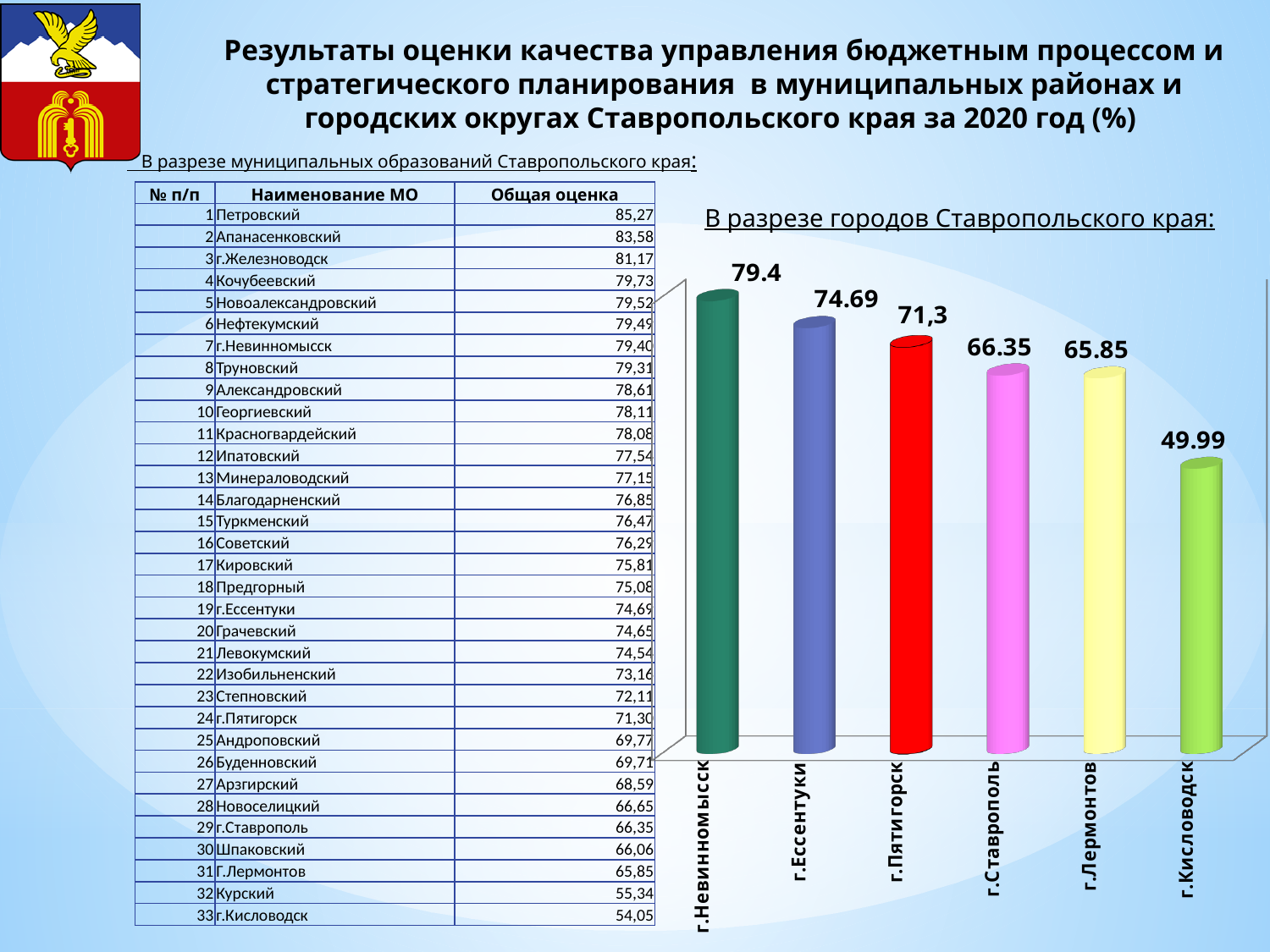
What is the value for г.Невинномысск in the chart? 79.4 Which has a larger value in the chart, г.Ставрополь or г.Лермонтов? г.Ставрополь What is the value for г.Кисловодск in the chart? 49.99 What is the value for г.Ессентуки in the chart? 74.69 What kind of chart is shown on the slide? Bar chart Do the values in the chart rise or fall from left to right? Fall How many cities are shown in the chart? 6 What is the value for г.Пятигорск in the chart? 71,3 Which city has the highest value in the chart? г.Невинномысск What is the difference between the values for г.Невинномысск and г.Ессентуки in the chart? 4.71 What is the difference between the values for г.Невинномысск and г.Кисловодск in the chart? 29.41 Which city has the lowest value in the chart? г.Кисловодск